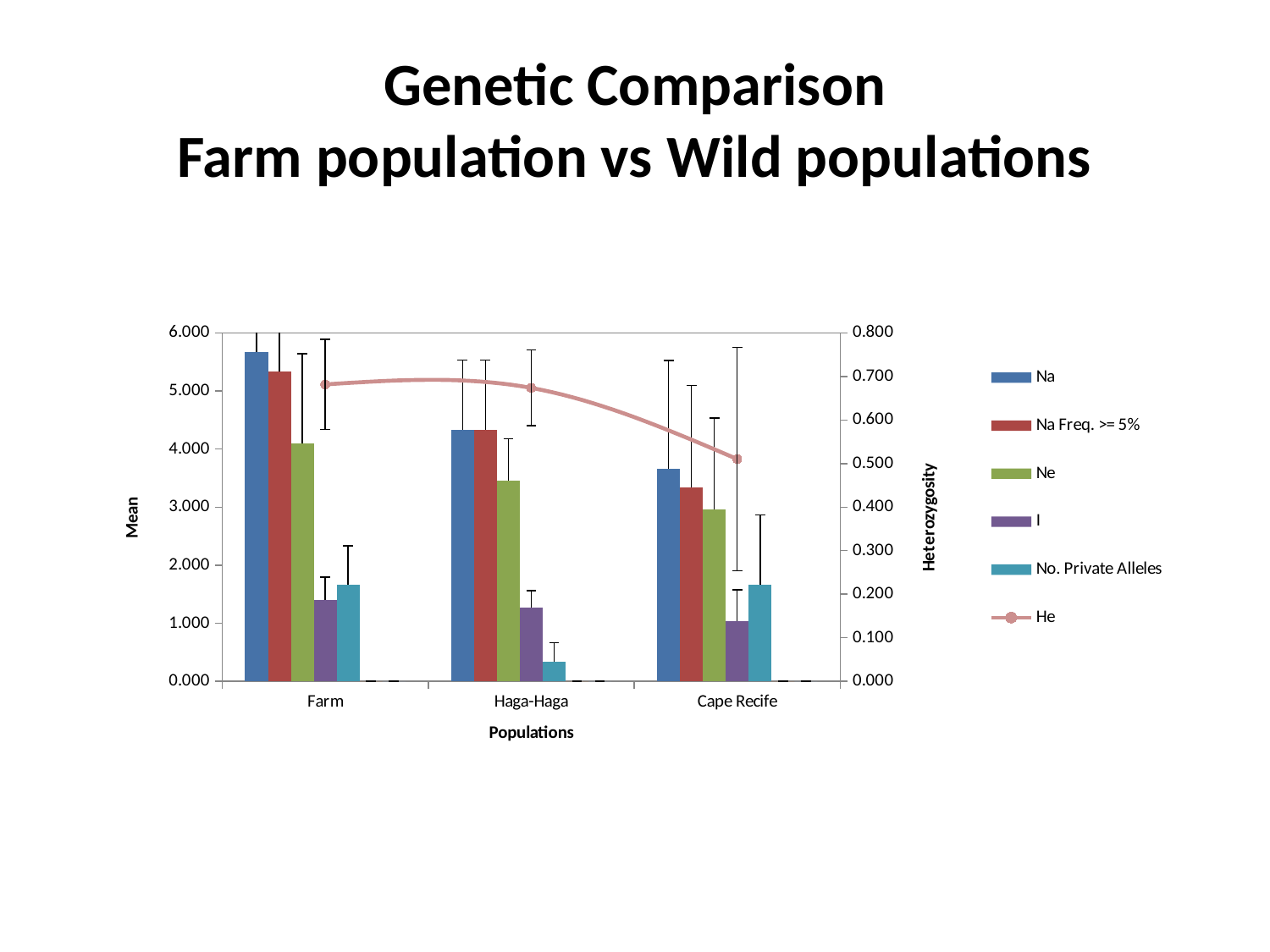
Is the He value for Cape Recife greater or less than 0.600? less Is the No. Private Alleles value for Haga-Haga greater or less than 1.000? less How many series does the chart's legend list? 6 Which population has the highest Na value? Farm What kind of chart is shown on the slide? A bar chart combined with a line Does the He line rise or fall from Farm to Cape Recife? fall Which population has the lowest Na value? Cape Recife Is the Na value for Farm greater or less than 5.000? greater Which is larger, the Na value for Farm or the Na value for Cape Recife? Farm How many populations are shown on the x axis of the chart? 3 What is the title of the right-hand vertical axis? Heterozygosity